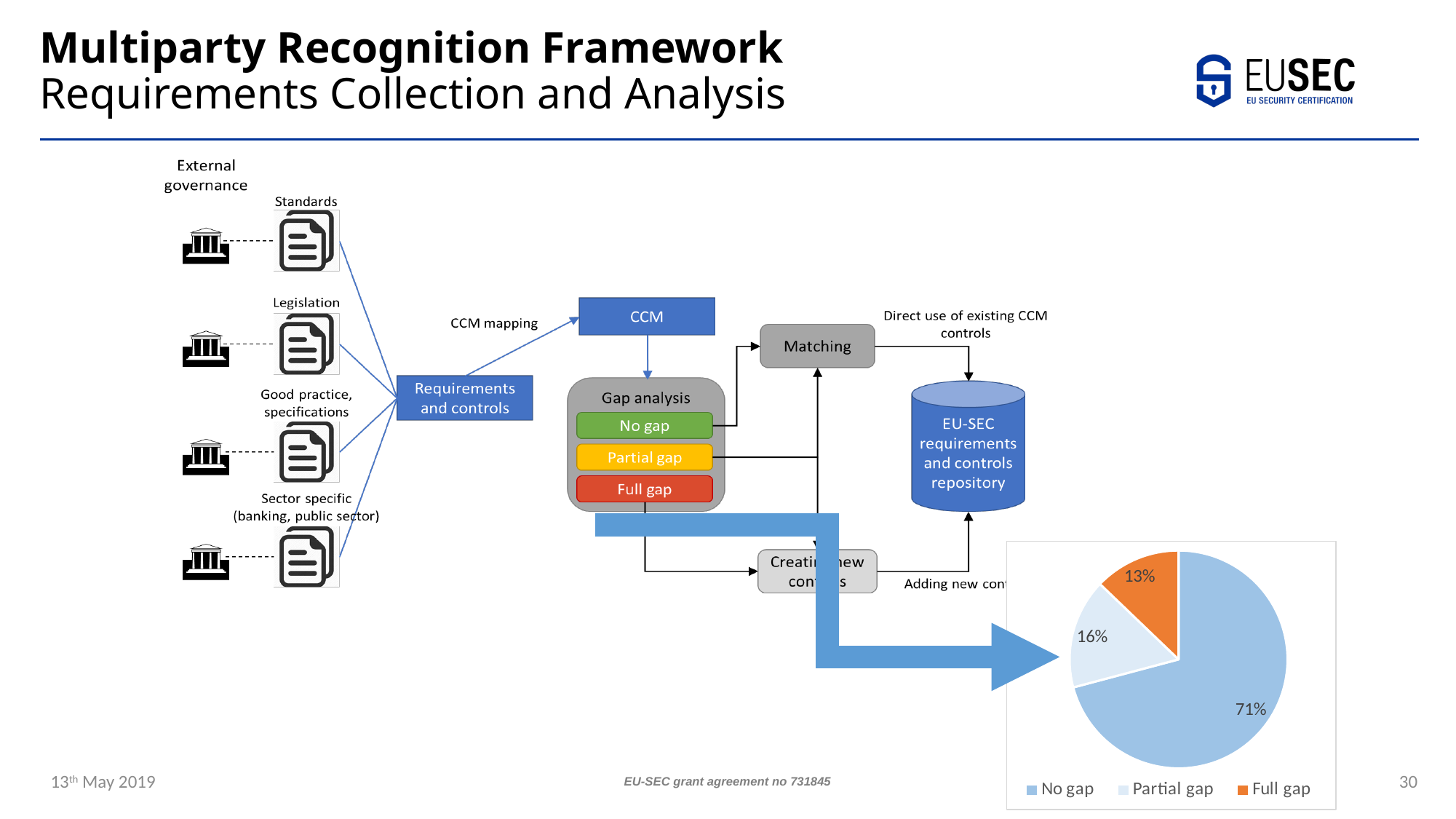
Which category has the smallest slice in the pie chart? Full gap Which slice is larger, Partial gap or Full gap? Partial gap What kind of chart is shown on the slide? pie chart What share of the pie chart is labelled No gap? 71% How many slices does the pie chart have? 3 What is the combined share of the Partial gap and Full gap slices? 29% Which category has the largest slice in the pie chart? No gap What is the difference in percentage points between the No gap and Partial gap slices? 55 What share of the pie chart is labelled Partial gap? 16% What share of the pie chart is labelled Full gap? 13% What colour is the Full gap slice in the pie chart? orange How many entries does the pie chart legend list? 3